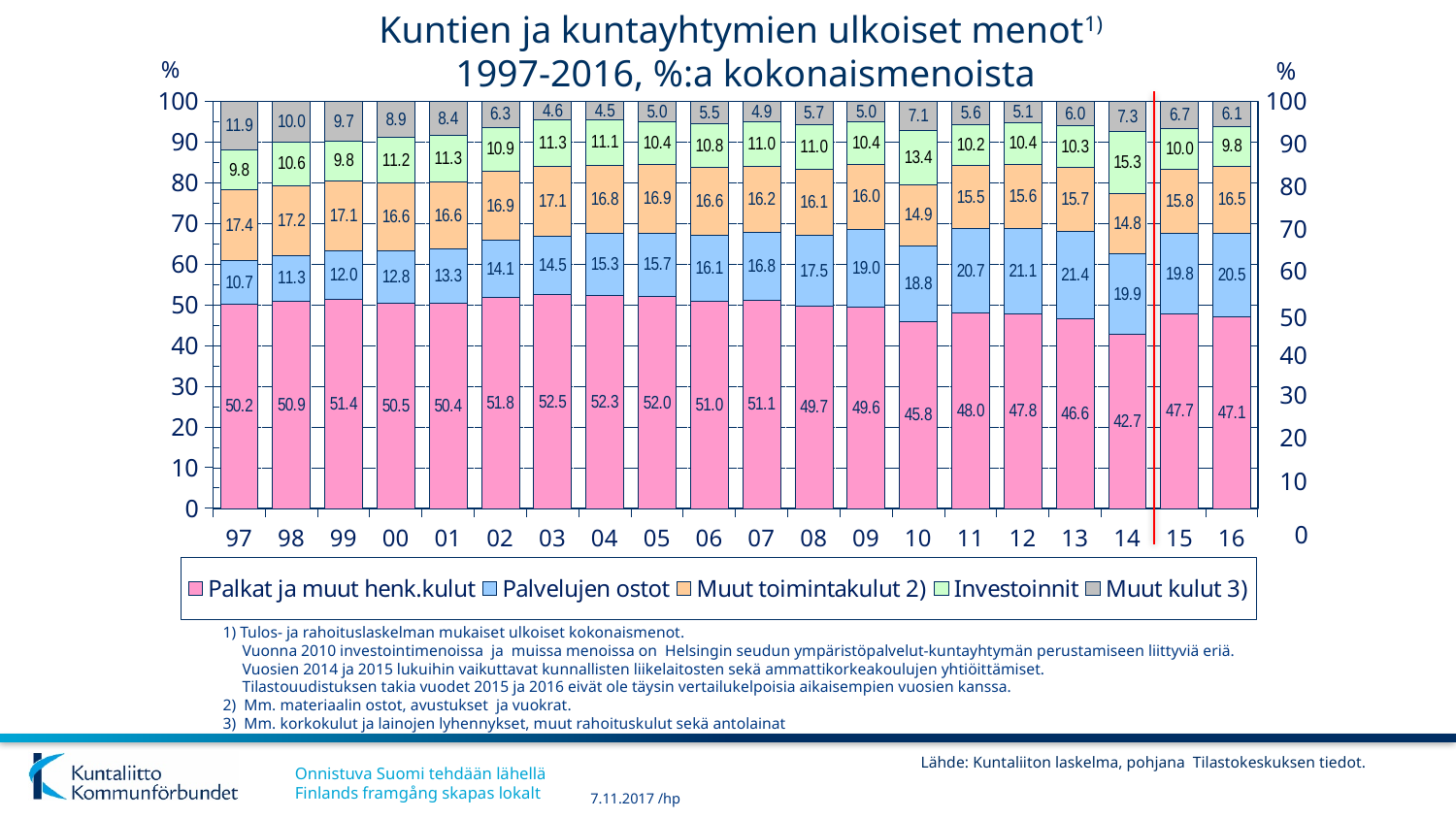
How many years are shown on the x axis? 20 What kind of chart is shown on the slide? Stacked bar chart Which is larger: Muut toimintakulut 2) in 1997 (97) or in 2014 (14)? 1997 (97) In which year is the Palkat ja muut henk.kulut share the lowest? 14 What is the difference between the Palvelujen ostot value in 2016 (16) and in 1997 (97)? 9.8 What is the value for Palkat ja muut henk.kulut in 2003 (03)? 52.5 How many series does the legend list? 5 What is the value for Investoinnit in 2010 (10)? 13.4 What is the total of the stacked bar for 2016 (16)? 100.0 Does the Palvelujen ostot share rise or fall from 1997 (97) to 2013 (13)? Rise What is the value for Palvelujen ostot in 2016 (16)? 20.5 In which year is the Muut kulut 3) share the highest? 97